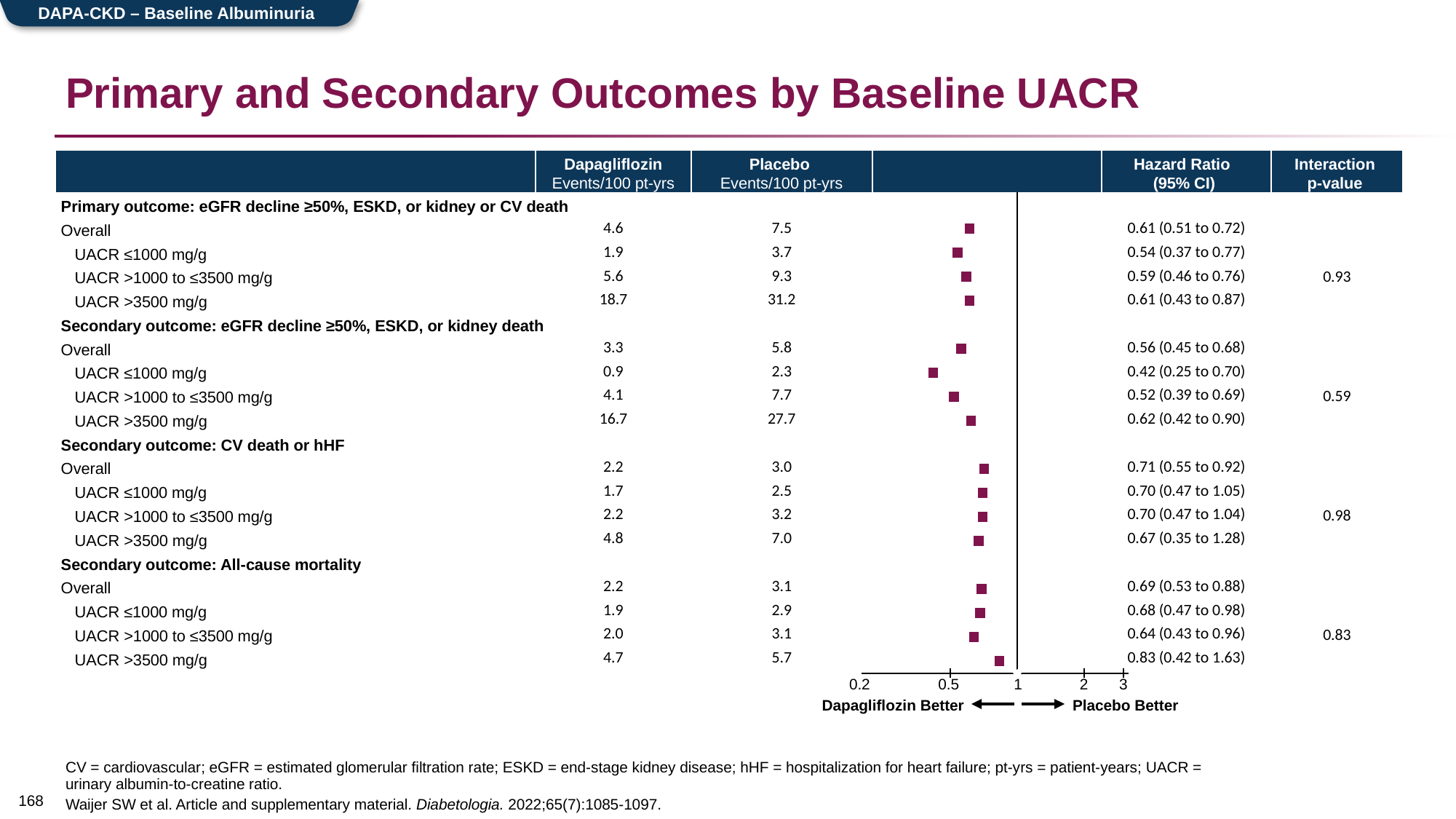
What is the difference between the placebo and dapagliflozin event rates for UACR >3500 mg/g for the primary outcome? 12.5 What is the dapagliflozin event rate (events/100 pt-yrs) for UACR >3500 mg/g for the primary outcome? 18.7 Which is larger: the hazard ratio for the Overall group for CV death or hHF, or the hazard ratio for the Overall group for the primary outcome? CV death or hHF (0.71) Which subgroup has the lowest hazard ratio on the forest plot? UACR ≤1000 mg/g (secondary outcome: eGFR decline ≥50%, ESKD, or kidney death) How many hazard ratio points are plotted on the forest plot? 16 For all-cause mortality, is the hazard ratio for UACR >3500 mg/g greater or less than 1? less What is the interaction p-value for the secondary outcome of CV death or hHF? 0.98 Which subgroup has the highest hazard ratio on the forest plot? UACR >3500 mg/g (secondary outcome: all-cause mortality) What label appears on the left side of the x axis below the forest plot? Dapagliflozin Better What is the placebo event rate (events/100 pt-yrs) for the Overall group for all-cause mortality? 3.1 What is the hazard ratio (95% CI) for the Overall group for the primary outcome? 0.61 (0.51 to 0.72) What kind of chart is shown on the slide? Forest plot